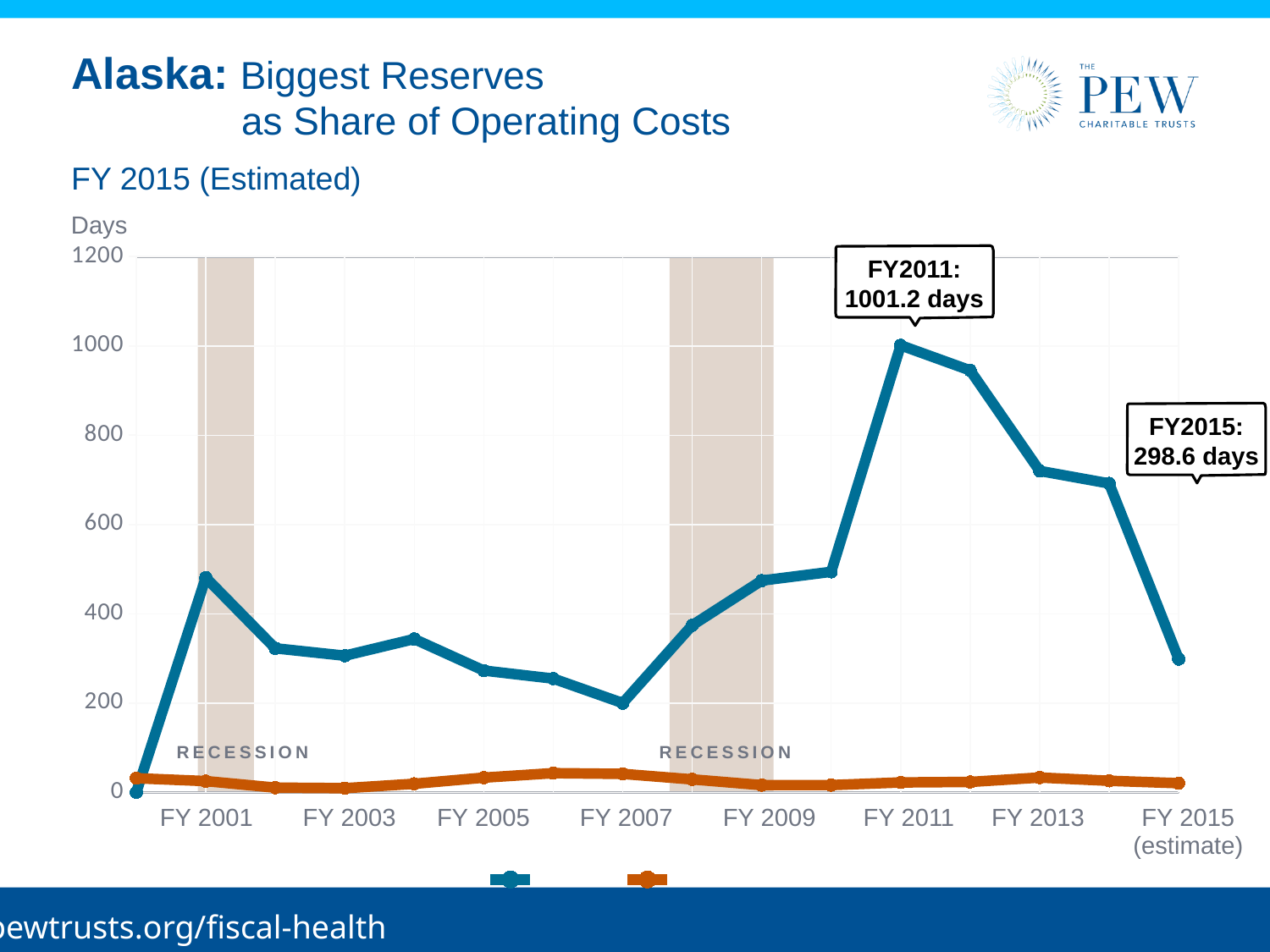
How many lines are plotted on the chart? 2 What value does the data label give for FY2011 on the blue line? 1001.2 days In which fiscal year does the blue line reach its highest value? FY 2011 Is the blue line's value for FY 2013 greater or less than 600? greater What value does the data label give for FY2015 (estimate) on the blue line? 298.6 days What kind of chart is shown on the slide? Line chart Does the blue line rise or fall between FY 2011 and FY 2015? Fall Which is larger on the blue line, the value for FY 2001 or the value for FY 2005? FY 2001 What unit is shown on the vertical axis of the chart? Days What is the difference between the labelled FY2011 value and the labelled FY2015 value? 702.6 days Is the blue line's value for FY 2001 greater or less than 400? greater Is the blue line's value for FY 2007 greater or less than 400? less